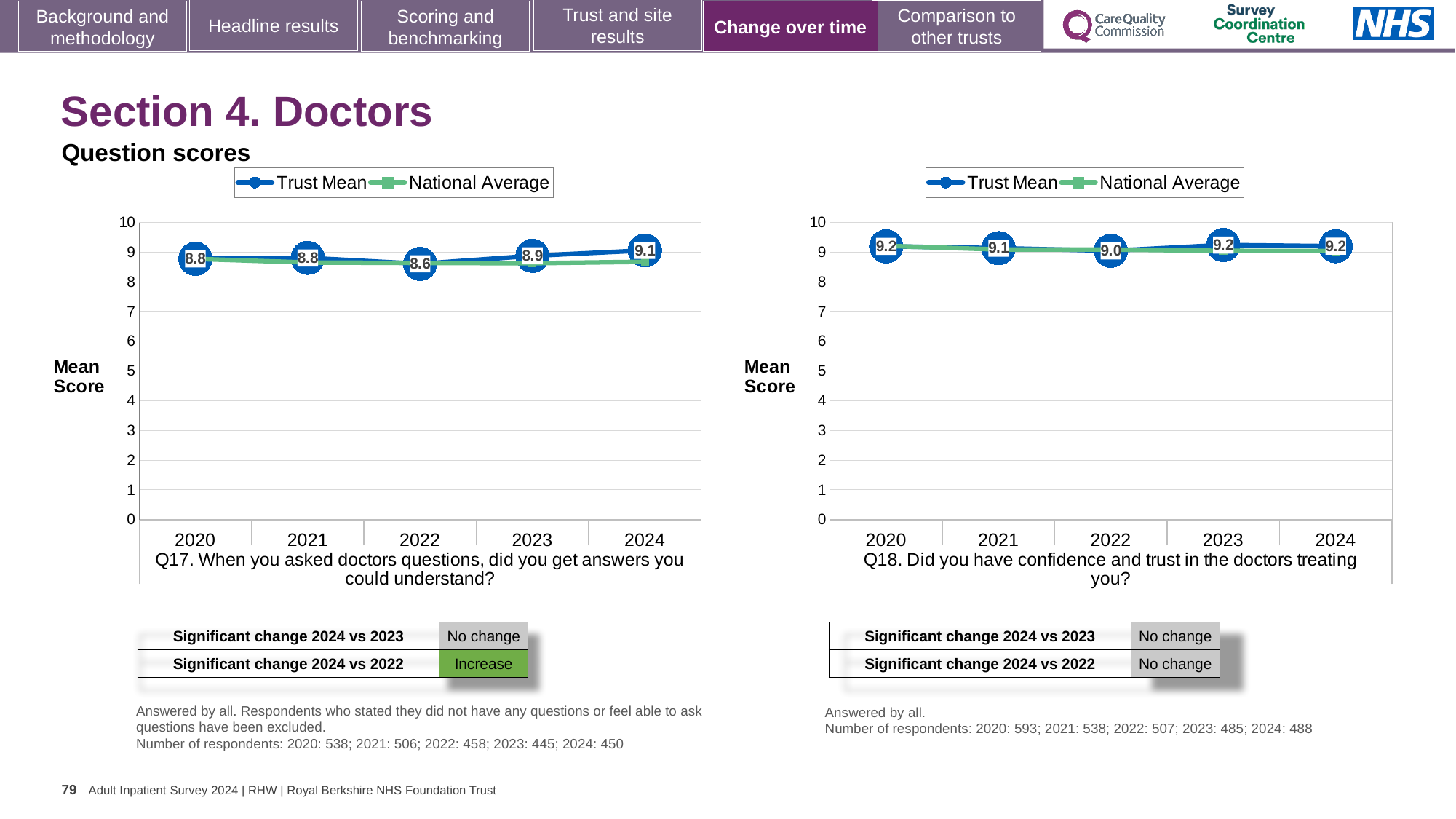
In the Q18 chart on the right, what is the difference between the Trust Mean scores for 2020 and 2022? 0.2 What kind of chart is the Q18 chart on the right? Line chart In the Q17 chart on the left, is the National Average value for 2024 greater or less than 8? greater In the Q17 chart on the left, what is the Trust Mean score for 2024? 9.1 In the Q17 chart on the left, which year has the highest Trust Mean score? 2024 In the Q17 chart on the left, what is the difference between the Trust Mean scores for 2024 and 2022? 0.5 In the Q17 chart on the left, which year has the lowest Trust Mean score? 2022 How many series does the legend of the Q17 chart on the left list? 2 In the Q17 chart on the left, which year has the larger Trust Mean score, 2020 or 2024? 2024 In the Q18 chart on the right, which year has the lowest Trust Mean score? 2022 In the Q18 chart on the right, what is the Trust Mean score for 2022? 9.0 How many years are shown on the x axis of the Q18 chart on the right? 5